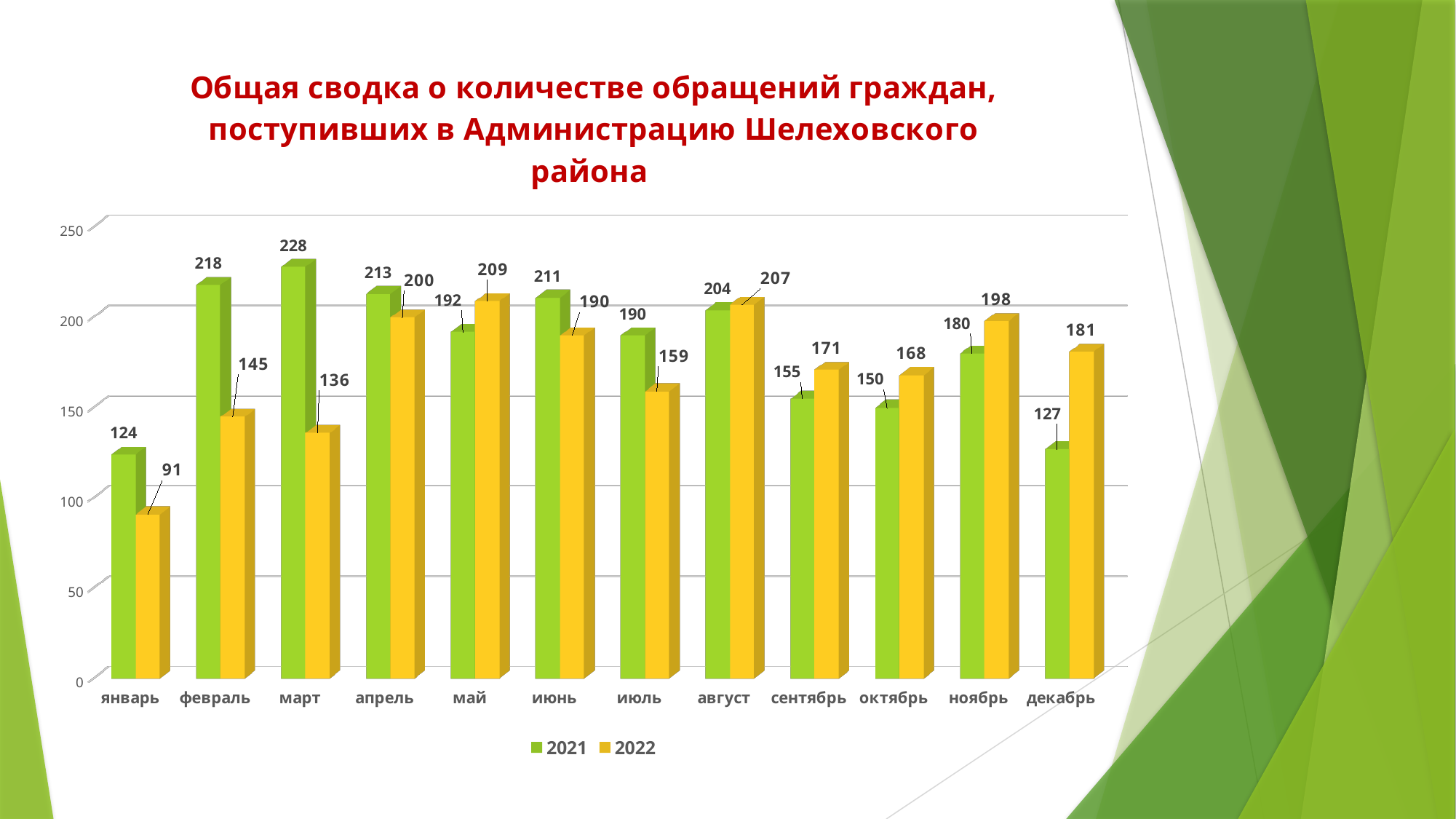
Which month has the highest value for the 2021 series? март What is the difference between the 2021 and 2022 values in февраль? 73 Which is larger in ноябрь, the 2021 value or the 2022 value? 2022 How many series does the legend list? 2 What kind of chart is shown on the slide? bar chart Which colour represents the 2022 series? yellow What is the value for 2022 in декабрь? 181 Is the value for 2021 in сентябрь greater or less than 150? greater How many months are shown on the x axis? 12 What is the value for 2021 in март? 228 Which month has the lowest value for the 2022 series? январь What is the value for 2022 in январь? 91